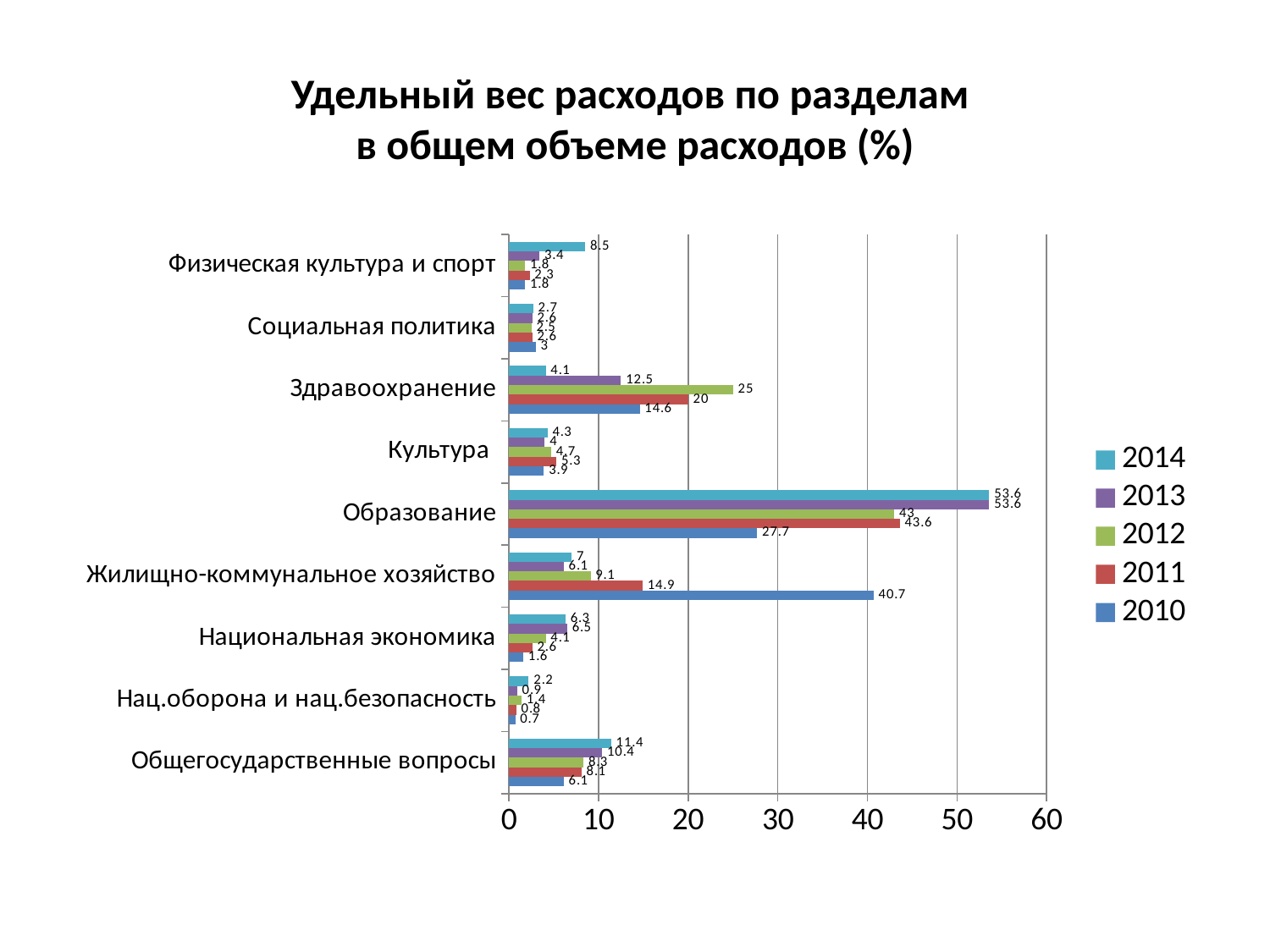
What kind of chart is shown on the slide? Bar chart What is the title of the chart? Удельный вес расходов по разделам в общем объеме расходов (%) Which category has the lowest value for 2010? Нац.оборона и нац.безопасность Which category has the highest value for 2014? Образование What is the difference between the 2014 and 2010 values for Образование? 25.9 What is the value for Образование in 2010? 27.7 How many categories are shown on the chart? 9 What is the difference between the 2012 and 2014 values for Здравоохранение? 20.9 For Жилищно-коммунальное хозяйство, which year has the larger value, 2011 or 2012? 2011 What is the value for Здравоохранение in 2012? 25 What is the value for Жилищно-коммунальное хозяйство in 2010? 40.7 How many series does the legend list? 5